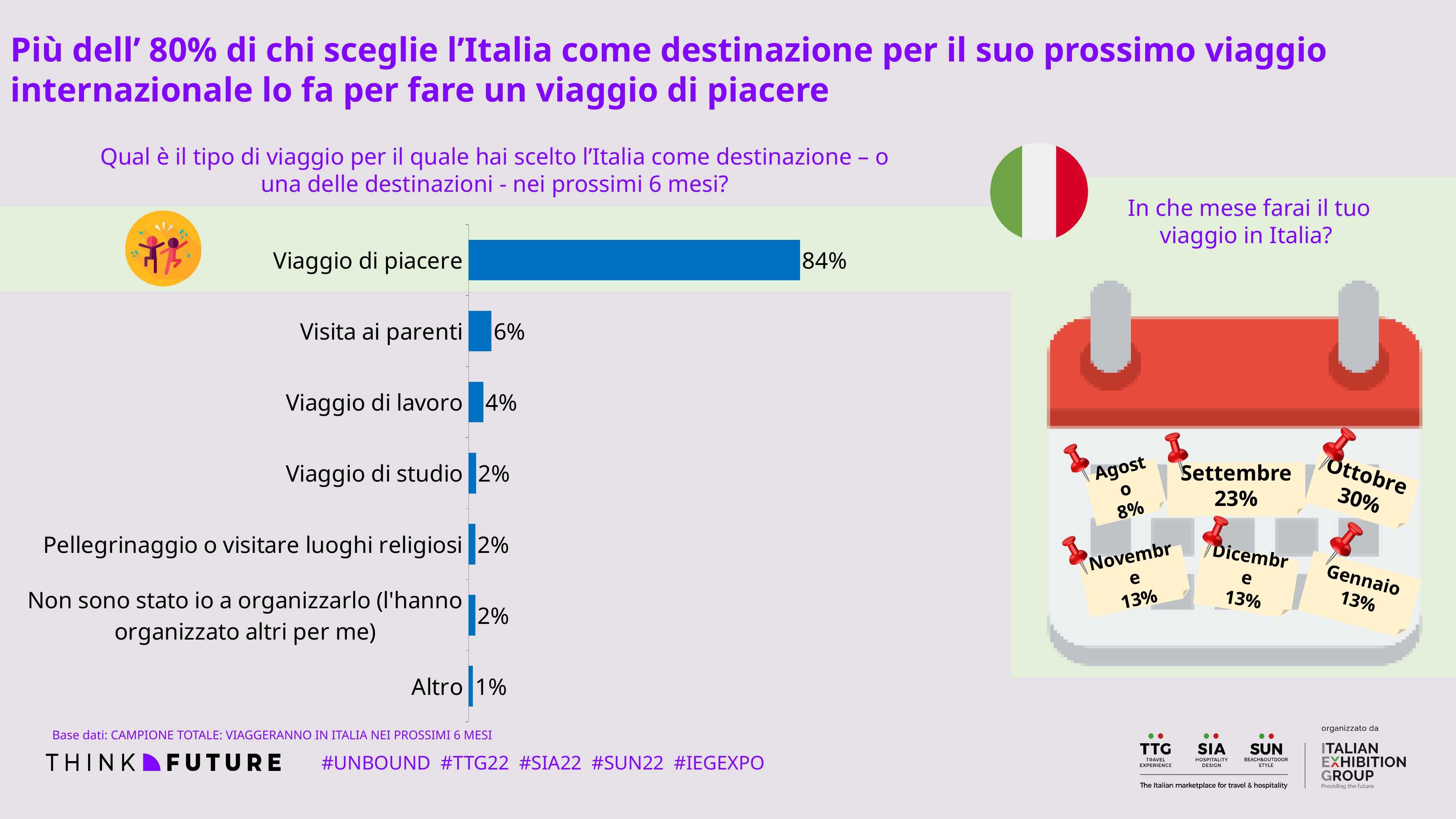
How many categories are shown in the bar chart? 7 What is the value for Viaggio di lavoro? 4% What is the value for Visita ai parenti? 6% What is the difference between the values for Viaggio di piacere and Visita ai parenti? 78% What colour are the bars in the chart? blue What is the value for Altro? 1% Which category has the highest value? Viaggio di piacere What is the value for Viaggio di studio? 2% What type of chart is shown on the slide? bar chart Which is larger, the value for Visita ai parenti or the value for Viaggio di lavoro? Visita ai parenti Which category has the lowest value? Altro What is the value for Viaggio di piacere? 84%